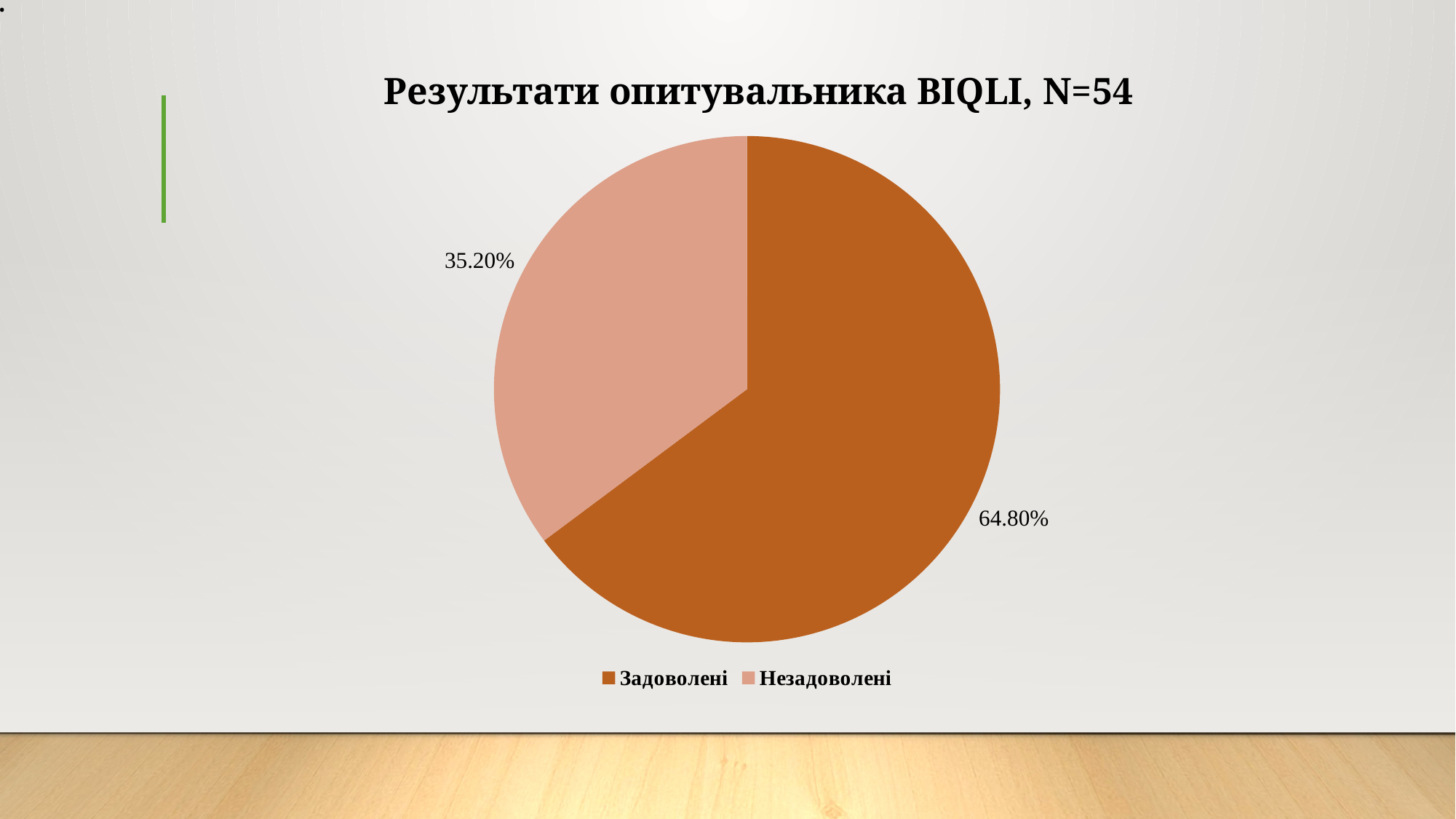
What kind of chart is shown on the slide? pie chart Which category has the smallest share of the pie? Незадоволені What is the sample size N stated in the chart title? 54 What percentage is shown for Незадоволені? 35.20% How many entries does the legend list? 2 What is the title of the chart? Результати опитувальника BIQLI, N=54 What percentage is shown for Задоволені? 64.80% Which category has the largest share of the pie? Задоволені What is the difference in percentage points between Задоволені and Незадоволені? 29.60% Which is larger, the share for Задоволені or for Незадоволені? Задоволені What colour is the slice for Незадоволені? light pink/salmon How many slices does the pie chart have? 2